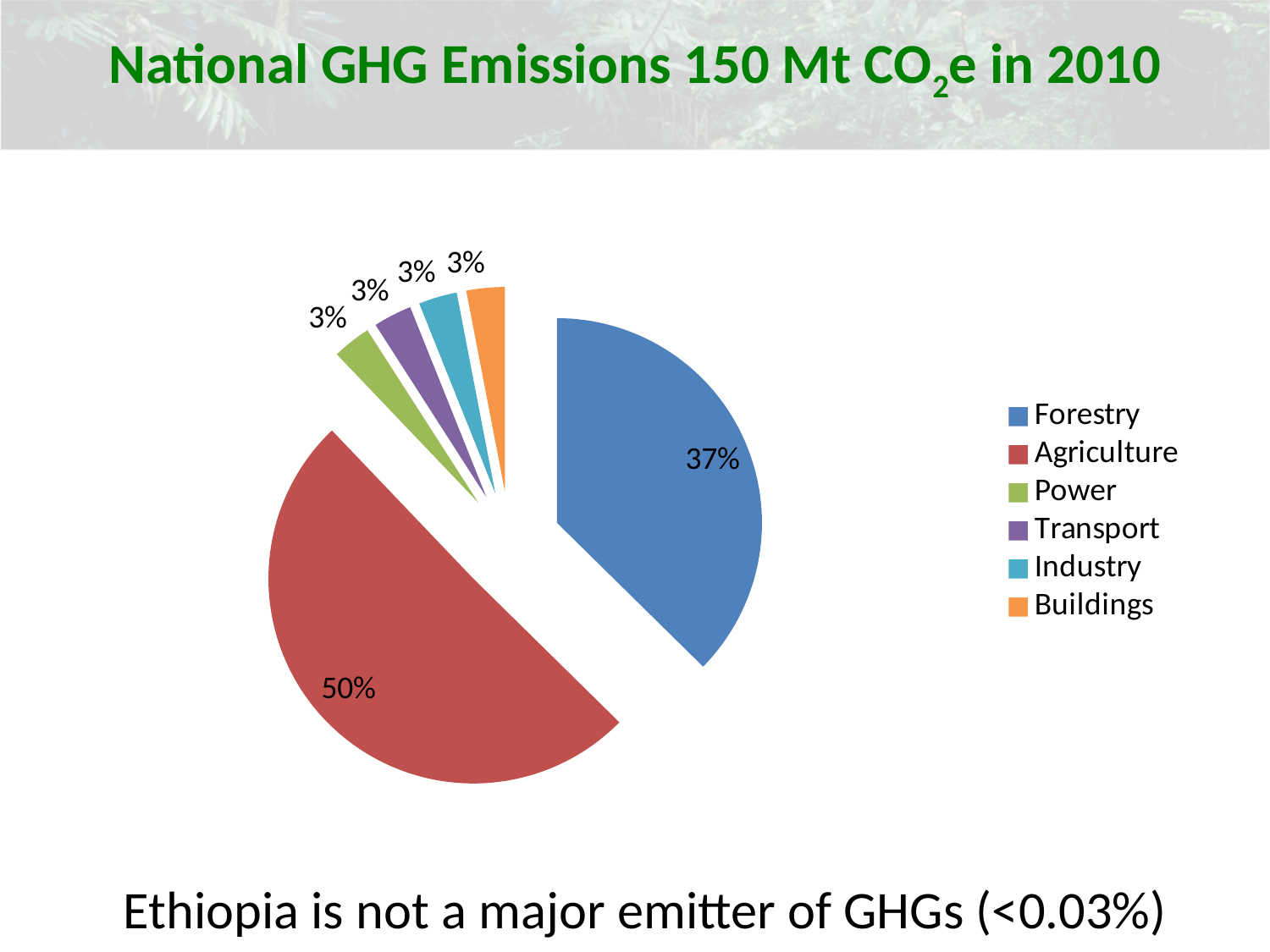
What share of national GHG emissions comes from Agriculture? 50% What kind of chart is shown on the slide? Pie chart Which colour represents Industry in the pie chart? Light blue What share of national GHG emissions comes from Forestry? 37% Which has a larger share of emissions, Forestry or Agriculture? Agriculture What is the combined share of Agriculture and Forestry? 87% Which sector has the largest share of national GHG emissions? Agriculture What share of national GHG emissions comes from Power? 3% What share of national GHG emissions comes from Buildings? 3% How many sectors are shown in the pie chart? 6 What is the difference in percentage points between the Agriculture and Forestry shares? 13 Which has a larger share of emissions, Forestry or Transport? Forestry